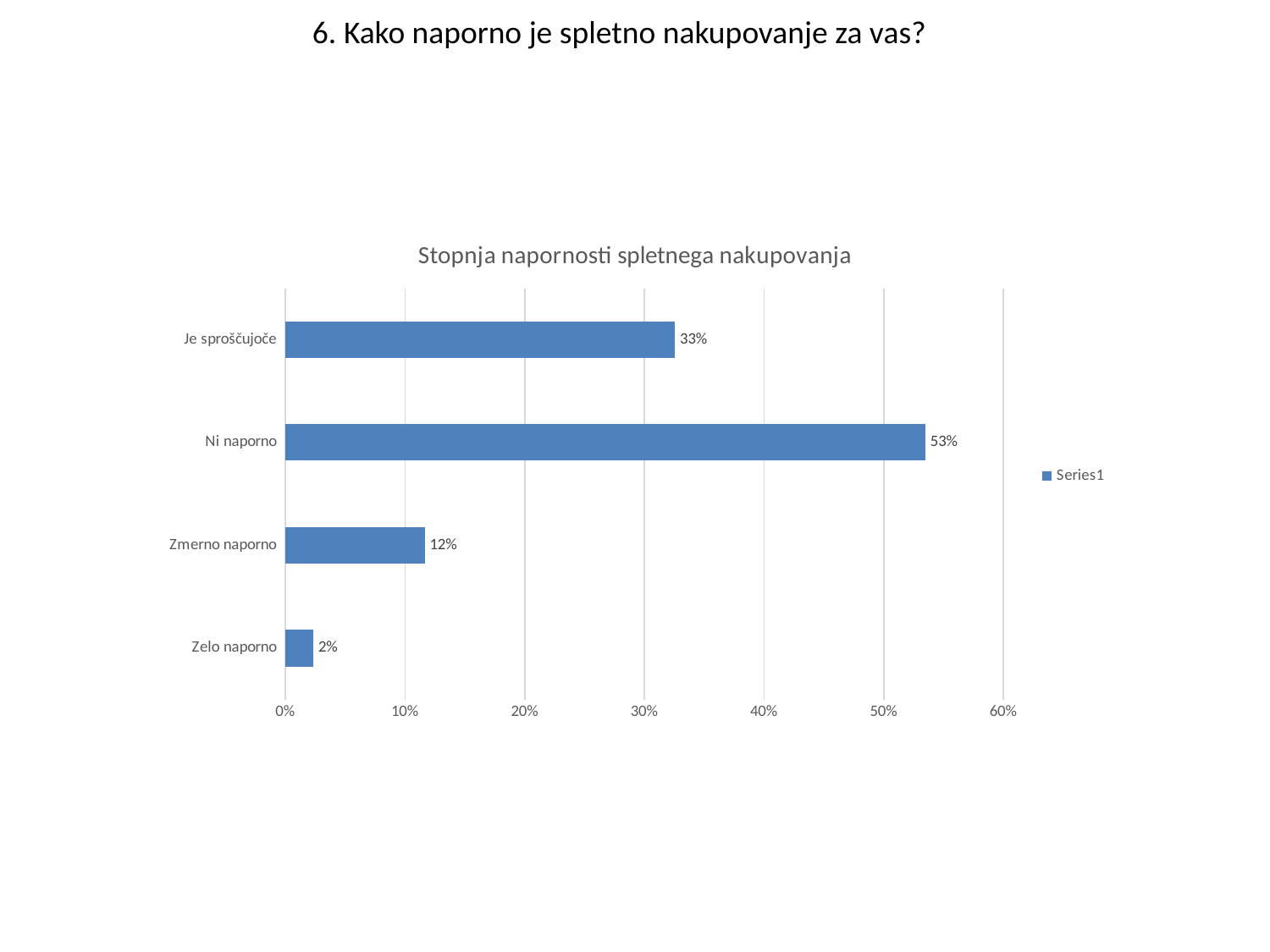
What is the value for "Je sproščujoče"? 33% What is the value for "Zmerno naporno"? 12% Which category has the highest value? Ni naporno What is the difference between the values for "Ni naporno" and "Je sproščujoče"? 20% Which category has the lowest value? Zelo naporno What kind of chart is shown on the slide? Bar chart Which is larger, the value for "Zmerno naporno" or the value for "Je sproščujoče"? Je sproščujoče Is the value for "Ni naporno" greater or less than 50%? greater What is the title of the chart? Stopnja napornosti spletnega nakupovanja What is the value for "Ni naporno"? 53% What is the value for "Zelo naporno"? 2% How many categories are shown in the chart? 4